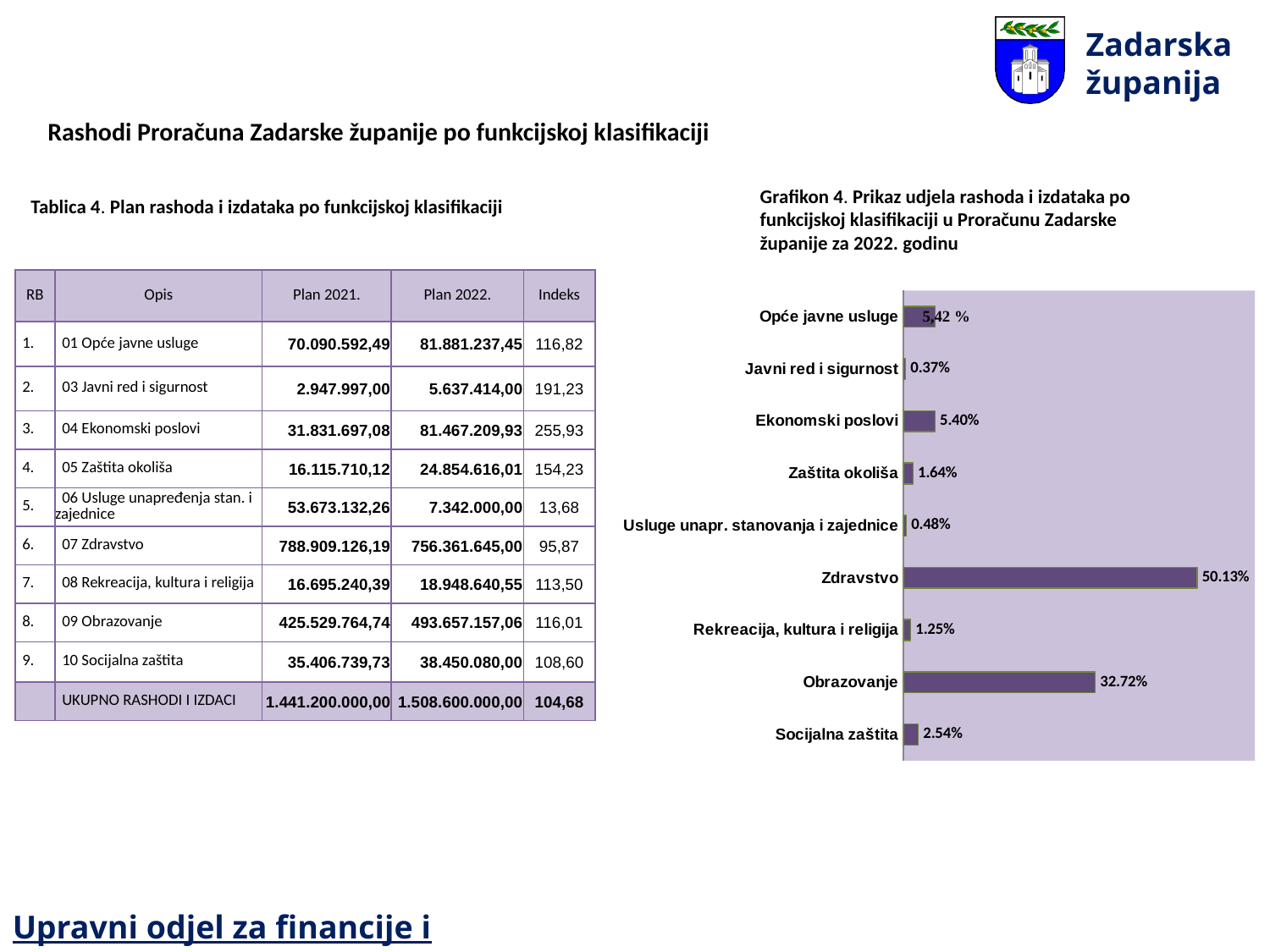
What is the value shown for Opće javne usluge in the bar chart? 5,42 % What is the value shown for Zdravstvo in the bar chart? 50.13% What type of chart is shown in Grafikon 4? bar chart Which is larger in the bar chart, Obrazovanje or Socijalna zaštita? Obrazovanje What is the value shown for Socijalna zaštita in the bar chart? 2.54% What is the value shown for Javni red i sigurnost in the bar chart? 0.37% What is the difference between the values for Zdravstvo and Obrazovanje in the bar chart? 17.41% What is the value shown for Obrazovanje in the bar chart? 32.72% How many categories are shown in the bar chart? 9 Which category has the lowest value in the bar chart? Javni red i sigurnost What is the title of the chart on the slide? Grafikon 4. Prikaz udjela rashoda i izdataka po funkcijskoj klasifikaciji u Proračunu Zadarske županije za 2022. godinu Which category has the highest value in the bar chart? Zdravstvo